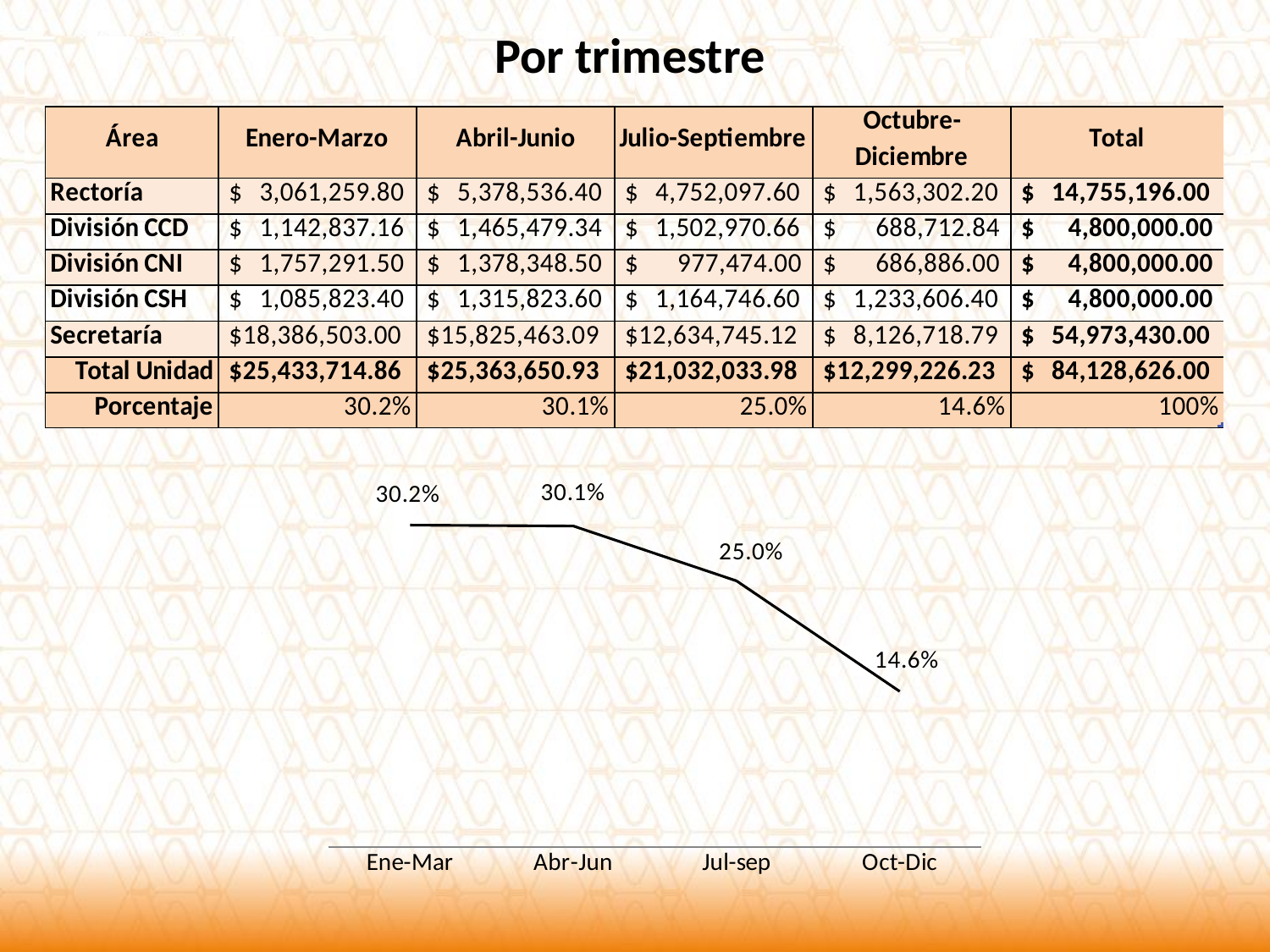
Which quarter has the lowest value in the line chart? Oct-Dic What kind of chart is shown below the table? line chart What is the value plotted for Abr-Jun in the line chart? 30.1% What is the value plotted for Jul-sep in the line chart? 25.0% Which quarter has the highest value in the line chart? Ene-Mar What is the difference between the Ene-Mar and Abr-Jun values in the line chart? 0.1% What is the difference between the Jul-sep and Oct-Dic values in the line chart? 10.4% What is the value plotted for Ene-Mar in the line chart? 30.2% In the line chart, which is larger: the value for Jul-sep or the value for Oct-Dic? Jul-sep How many quarters are plotted along the x axis of the line chart? 4 What is the value plotted for Oct-Dic in the line chart? 14.6% Do the values in the line chart rise or fall from Ene-Mar to Oct-Dic? fall